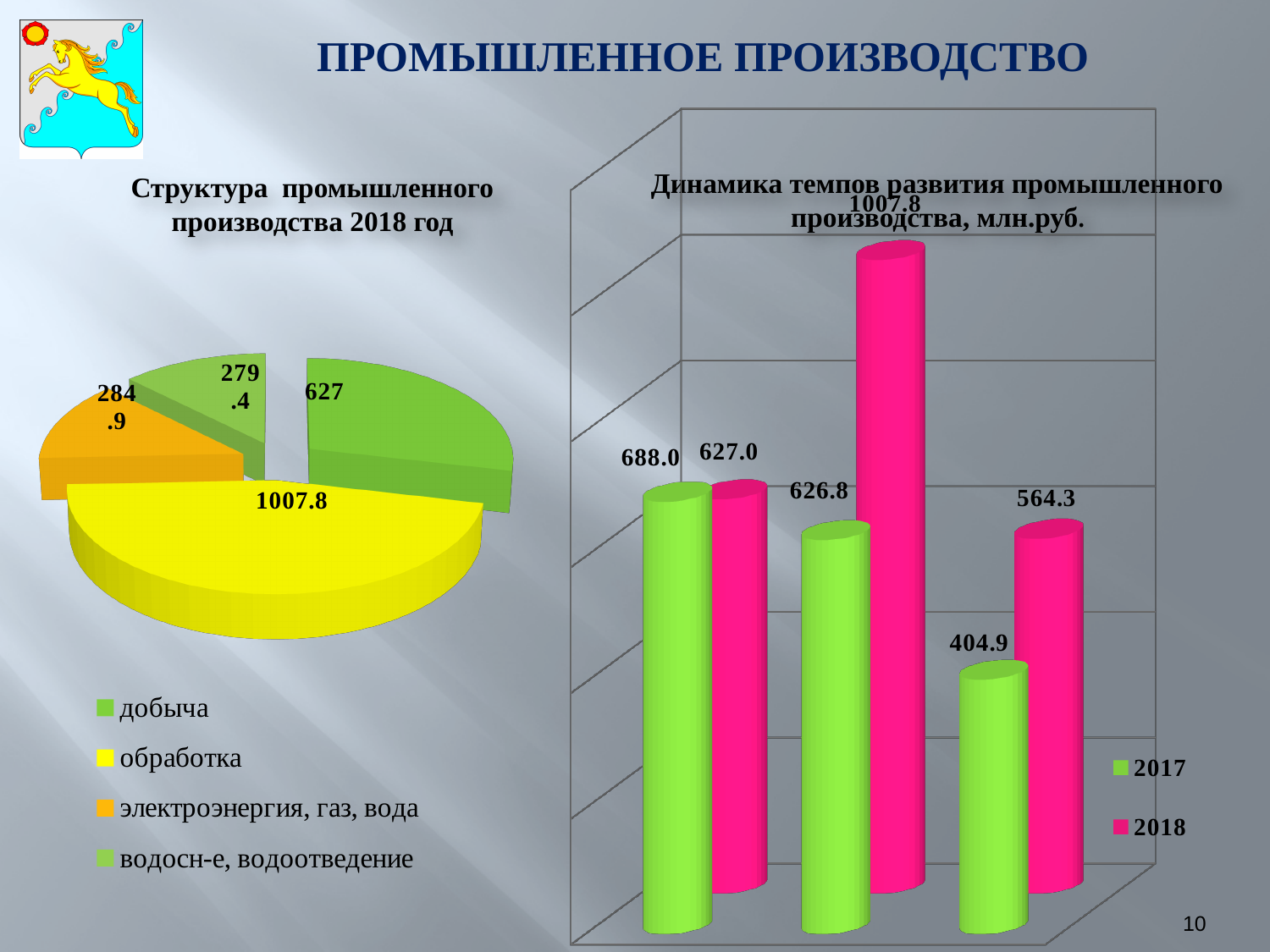
In the chart 'Динамика темпов развития промышленного производства, млн.руб.', what is the lowest value shown? 404.9 In the pie chart 'Структура промышленного производства 2018 год', how many slices are there? 4 In the pie chart 'Структура промышленного производства 2018 год', what is the value for обработка? 1007.8 In the chart 'Динамика темпов развития промышленного производства, млн.руб.', what is the highest value shown? 1007.8 In the pie chart 'Структура промышленного производства 2018 год', which category has the smallest slice? водосн-е, водоотведение What kind of chart is the chart on the left of the slide? pie chart What kind of chart is 'Динамика темпов развития промышленного производства, млн.руб.'? bar chart In the pie chart 'Структура промышленного производства 2018 год', what is the value for добыча? 627 In the chart 'Динамика темпов развития промышленного производства, млн.руб.', how many series does the legend list? 2 In the chart 'Динамика темпов развития промышленного производства, млн.руб.', in the first group of bars, what is the difference between the 2017 value and the 2018 value? 61.0 In the pie chart 'Структура промышленного производства 2018 год', what is the difference between добыча and электроэнергия, газ, вода? 342.1 In the pie chart 'Структура промышленного производства 2018 год', which category has the largest slice? обработка